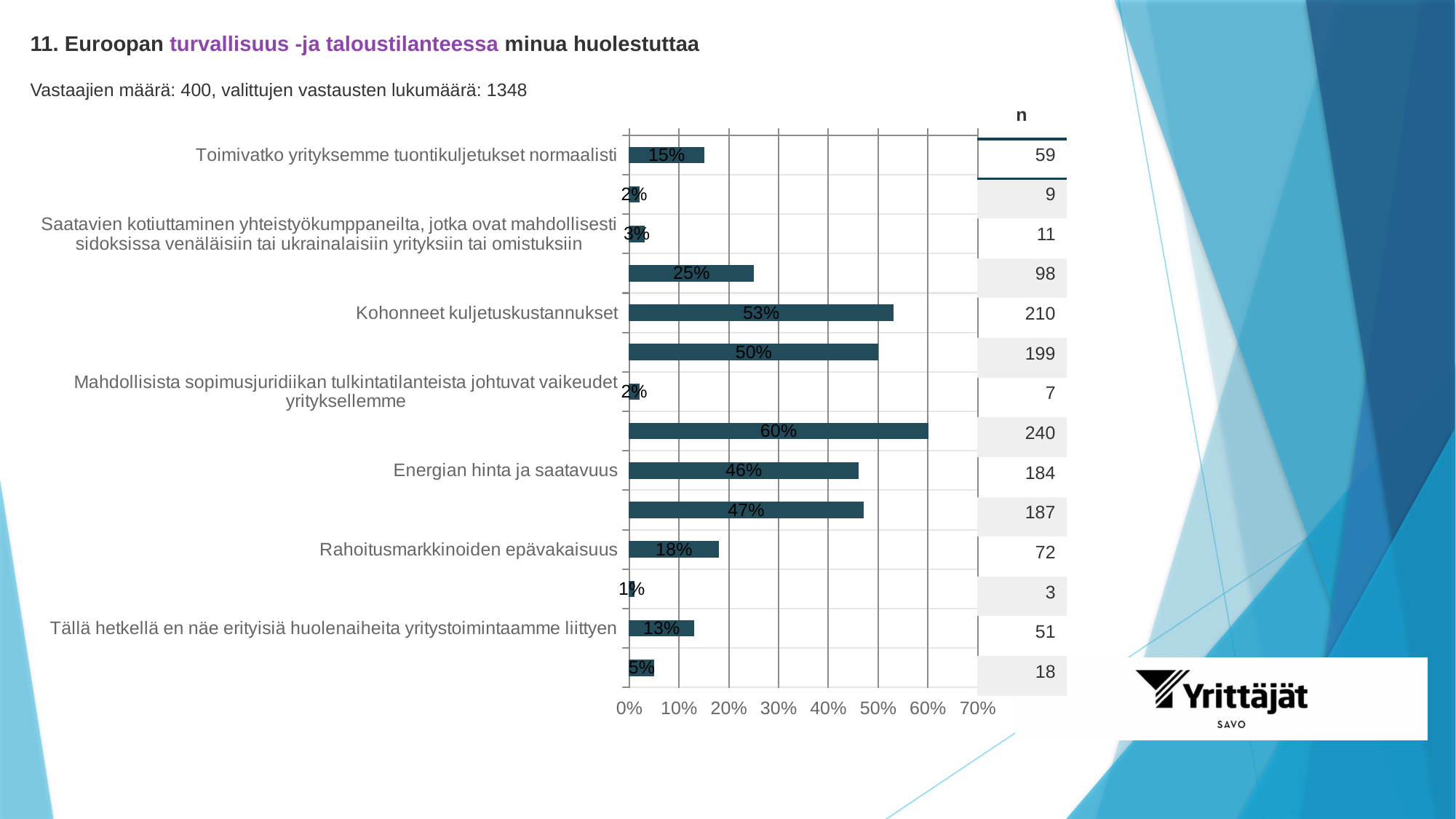
What is the n value shown in the table for "Tällä hetkellä en näe erityisiä huolenaiheita yritystoimintaamme liittyen"? 51 What percentage is shown for "Toimivatko yrityksemme tuontikuljetukset normaalisti"? 15% What is the difference in percentage points between "Kohonneet kuljetuskustannukset" and "Energian hinta ja saatavuus"? 7 percentage points What is the n value shown in the table for "Kohonneet kuljetuskustannukset"? 210 What percentage is shown for "Energian hinta ja saatavuus"? 46% What is the smallest percentage value labelled on any bar in the chart? 1% What percentage is shown for "Kohonneet kuljetuskustannukset"? 53% What is the largest percentage value labelled on any bar in the chart? 60% What kind of chart is shown on the slide? Bar chart Which has the higher percentage: "Rahoitusmarkkinoiden epävakaisuus" or "Toimivatko yrityksemme tuontikuljetukset normaalisti"? Rahoitusmarkkinoiden epävakaisuus What is the highest value shown on the percentage axis of the chart? 70% What percentage is shown for "Rahoitusmarkkinoiden epävakaisuus"? 18%